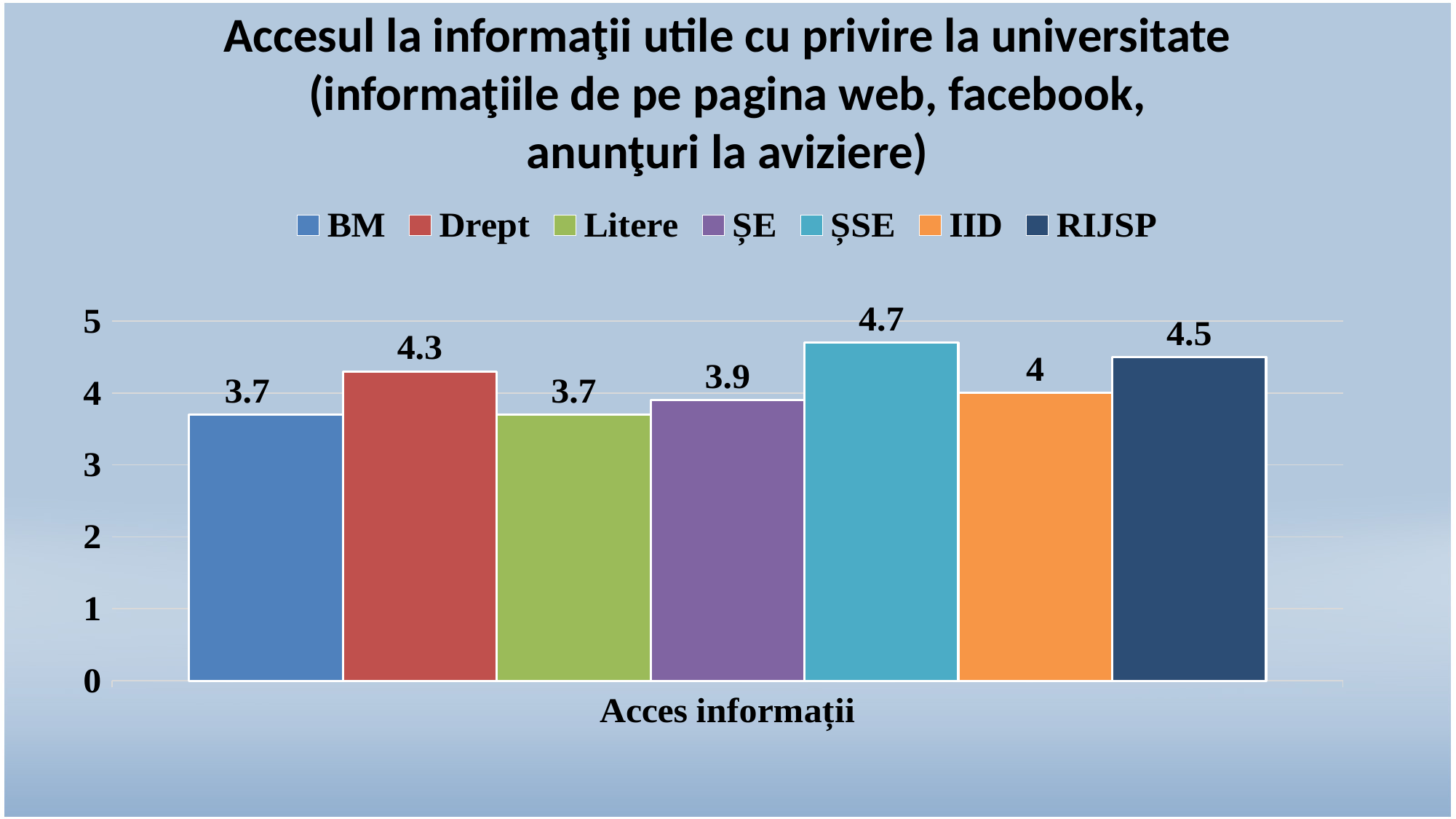
What is the value for ȘE? 3.9 How many series does the legend list? 7 What is the label on the x axis of the chart? Acces informații Which series has the highest value? ȘSE What is the value for IID? 4 What is the value for Drept? 4.3 Which is larger, the value for Drept or the value for IID? Drept What is the difference between the values for RIJSP and Drept? 0.2 Is the value for Litere greater or less than 4? less What kind of chart is shown on the slide? bar chart What is the value for ȘSE? 4.7 What is the difference between the values for ȘSE and BM? 1